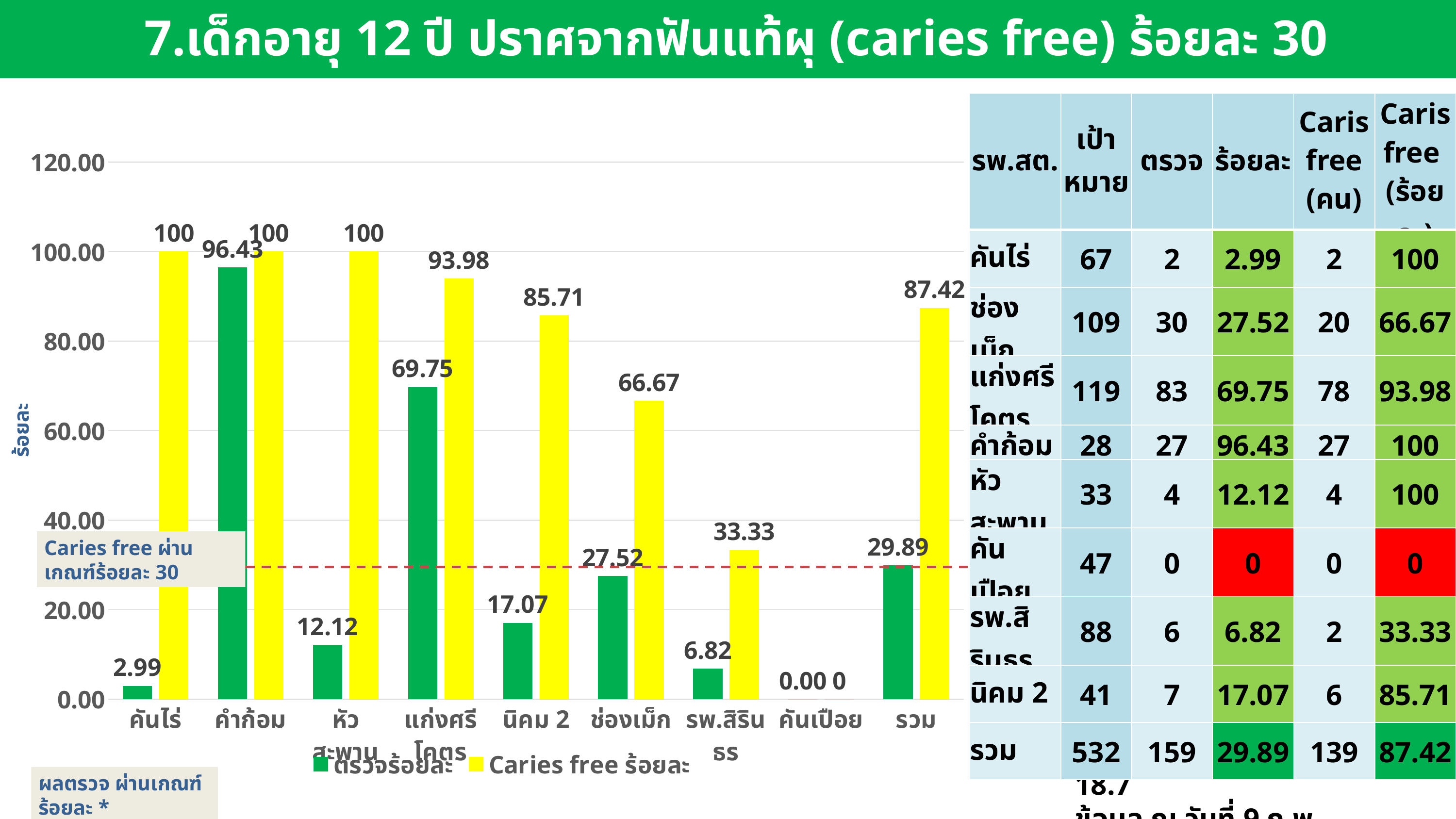
Which category has the lowest Caries free ร้อยละ value? คันเปือย What type of chart is shown on the slide? bar chart What is the Caries free ร้อยละ value for แก่งศรีโคตร? 93.98 What is the ตรวจร้อยละ value for รวม? 29.89 What is the ตรวจร้อยละ value for คำก้อม? 96.43 How many categories are shown on the x axis of the chart? 9 What is the difference between the Caries free ร้อยละ values for นิคม 2 and ช่องเม็ก? 19.04 Which category has the highest ตรวจร้อยละ value? คำก้อม Which is larger, the ตรวจร้อยละ value for ช่องเม็ก or for นิคม 2? ช่องเม็ก What colour are the Caries free ร้อยละ bars in the chart? yellow Is the Caries free ร้อยละ value for รพ.สิรินธร greater or less than 40? less How many series does the chart legend list? 2